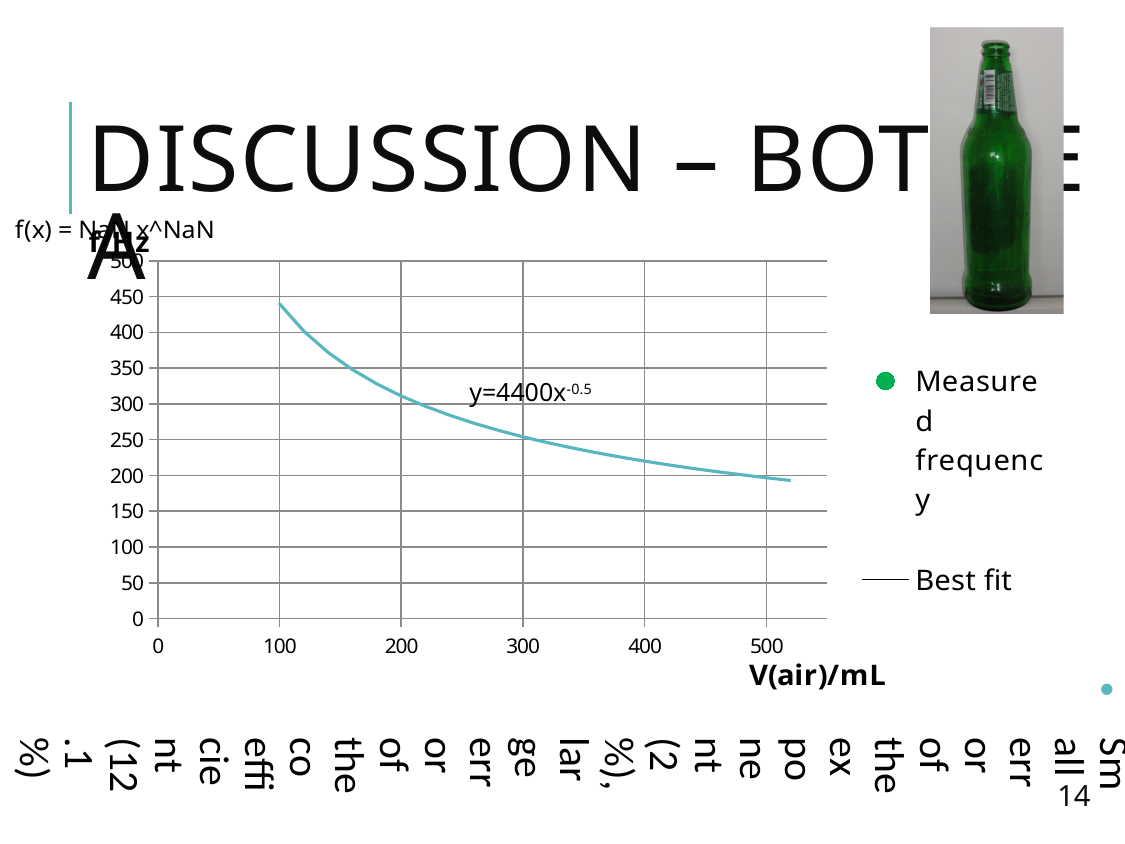
How many series does the legend list? 2 Is the best-fit frequency at V(air) = 300 mL greater or less than 300 Hz? less Which is larger, the best-fit frequency at 100 mL or at 500 mL? 100 mL Does the frequency rise or fall as V(air)/mL increases along the x axis? fall Is the best-fit frequency at V(air) = 500 mL greater or less than 250 Hz? less Is the best-fit frequency at V(air) = 100 mL greater or less than 400 Hz? greater What is the title of the x axis of the chart? V(air)/mL What kind of chart is shown on the slide? line chart What equation is printed on the chart for the best-fit curve? y=4400x^-0.5